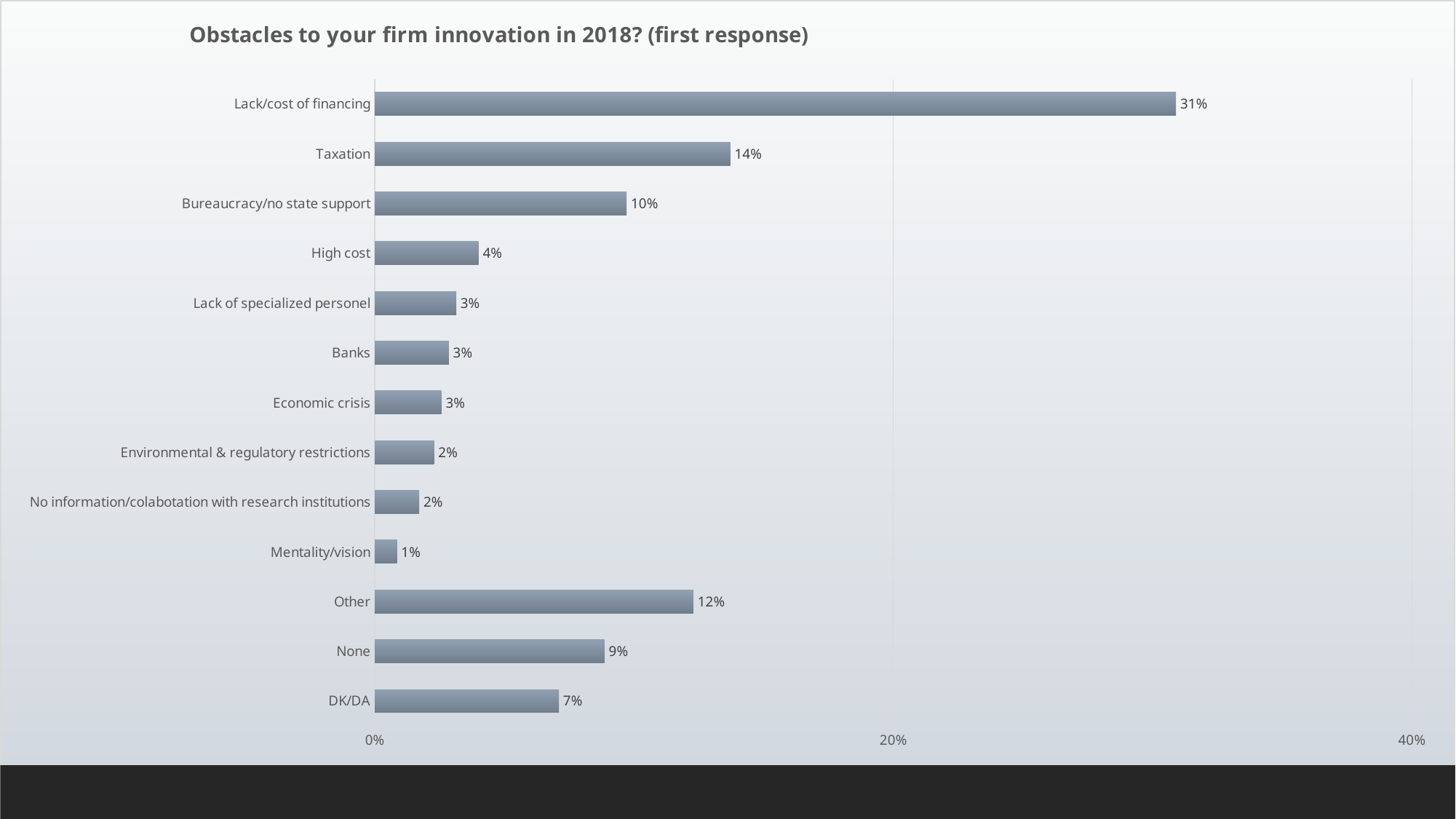
Is the value for Lack/cost of financing greater or less than 20%? greater Which category has the lowest percentage? Mentality/vision What is the value shown for Taxation? 14% How many categories are shown in the chart? 13 What is the title of the chart? Obstacles to your firm innovation in 2018? (first response) Which is larger, the value for Other or the value for None? Other Which obstacle has the highest percentage? Lack/cost of financing What percentage of firms cited Lack/cost of financing as an obstacle to innovation? 31% What is the difference between the values for Lack/cost of financing and Taxation? 17% What type of chart is shown on the slide? Bar chart What is the value for DK/DA? 7% What percentage is shown for Bureaucracy/no state support? 10%